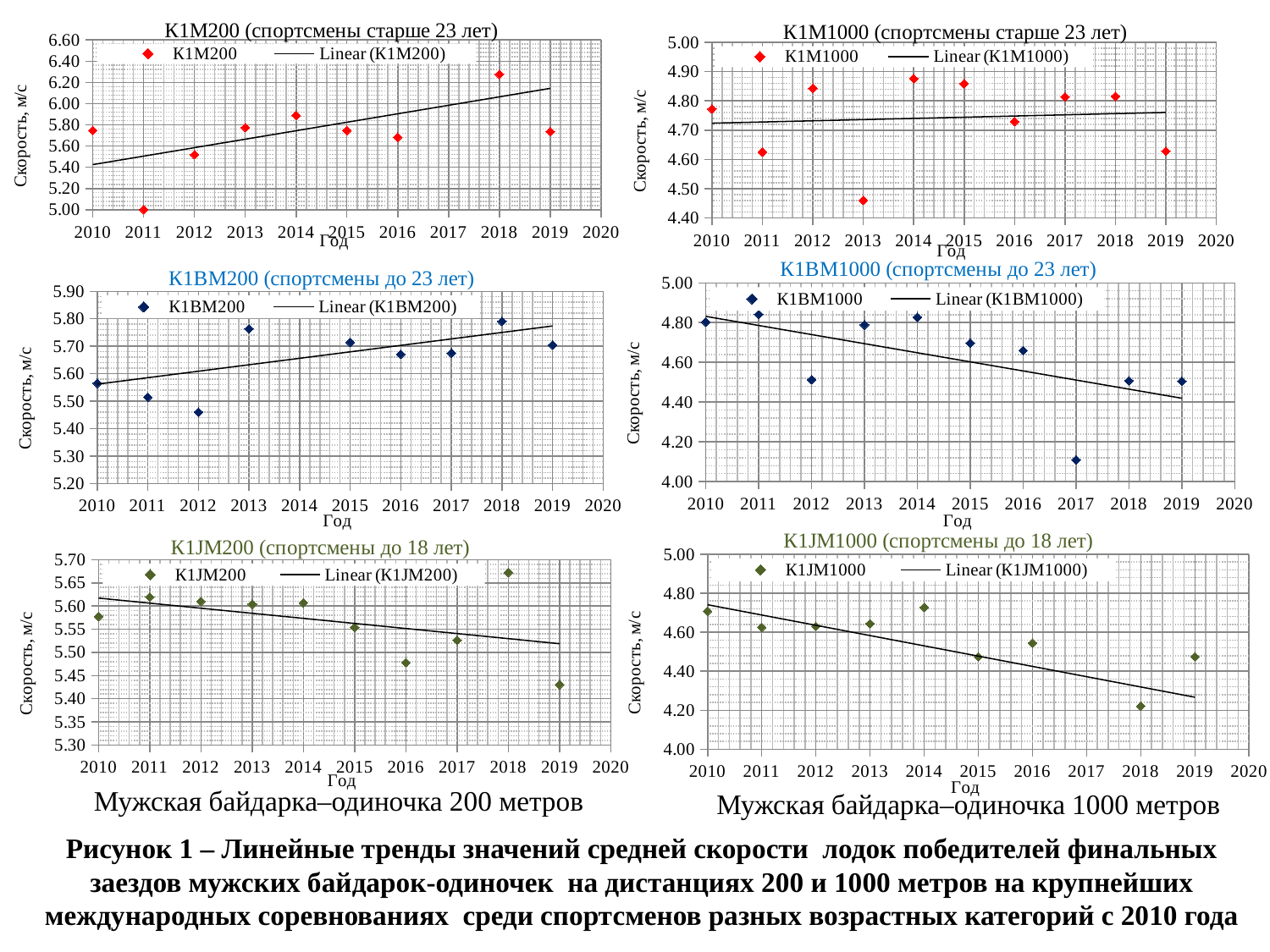
In the K1M200 (спортсмены старше 23 лет) chart, is the value for 2018 greater or less than 6.20? greater In the K1JM200 (спортсмены до 18 лет) chart, which is larger, the value for 2016 or the value for 2011? 2011 How many series does the legend of the K1JM1000 (спортсмены до 18 лет) chart list? 2 In the K1M200 (спортсмены старше 23 лет) chart, which year has the lowest speed value? 2011 In the K1BM1000 (спортсмены до 23 лет) chart, which year has the lowest speed value? 2017 In the K1BM1000 (спортсмены до 23 лет) chart, does the linear trend line rise or fall from 2010 to 2019? fall In the K1M1000 (спортсмены старше 23 лет) chart, is the value for 2013 greater or less than 4.50? less In the K1M1000 (спортсмены старше 23 лет) chart, which year has the lowest speed value? 2013 In the K1JM200 (спортсмены до 18 лет) chart, which year has the highest speed value? 2018